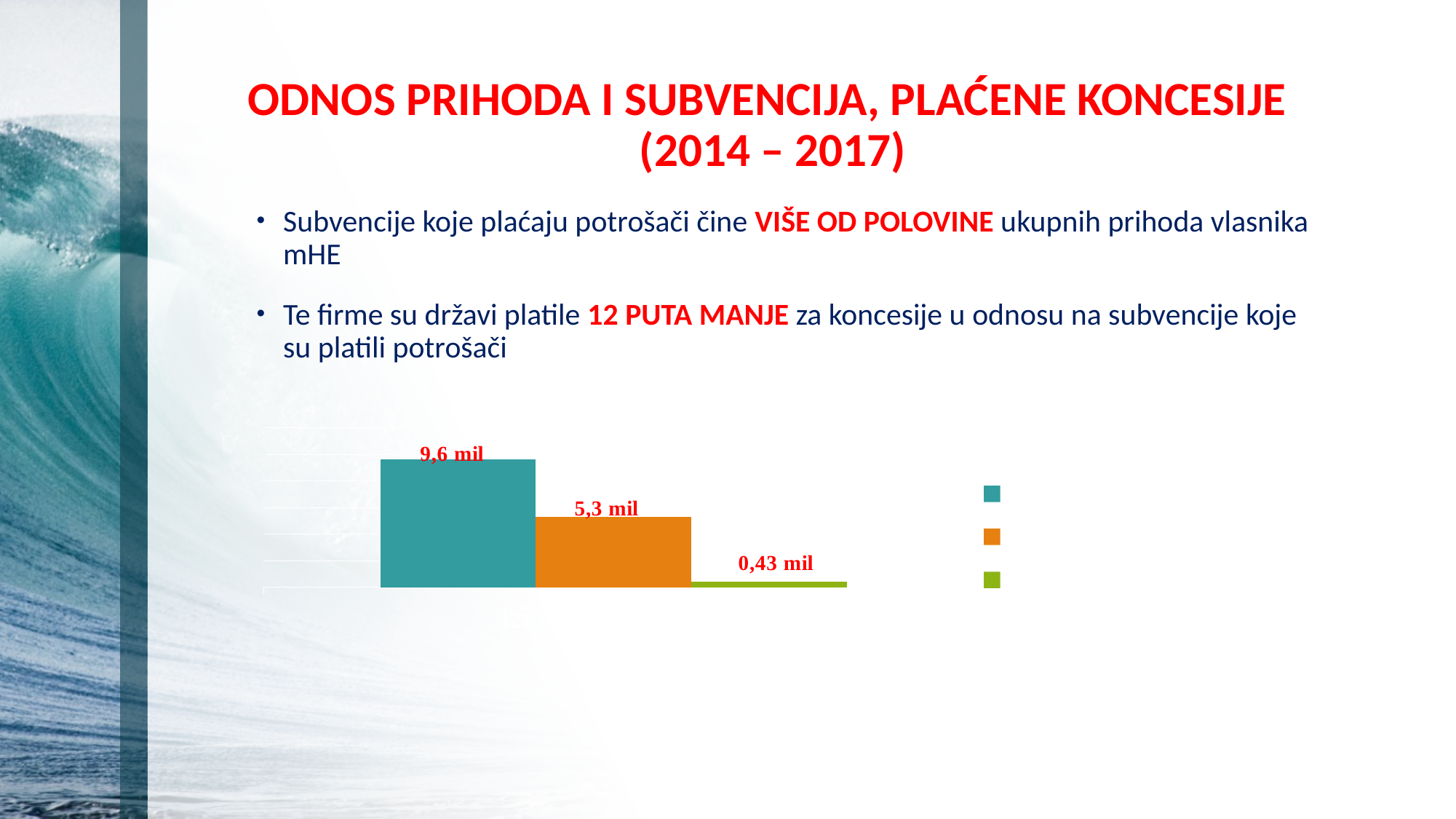
What value is printed on the teal bar in the chart? 9,6 mil What type of chart is shown on the slide? bar chart What value is printed on the green bar in the chart? 0,43 mil How many entries does the chart's legend show? 3 Do the bar values rise or fall from left to right in the chart? fall What is the difference between the teal bar and the orange bar in the chart? 4,3 mil What value is printed on the orange bar in the chart? 5,3 mil Which bar in the chart has the lowest value? the green bar (0,43 mil) What colour is the bar labelled 0,43 mil in the chart? green Which bar in the chart has the highest value? the teal bar (9,6 mil) Which is larger in the chart, the orange bar or the green bar? the orange bar How many bars are plotted in the chart? 3